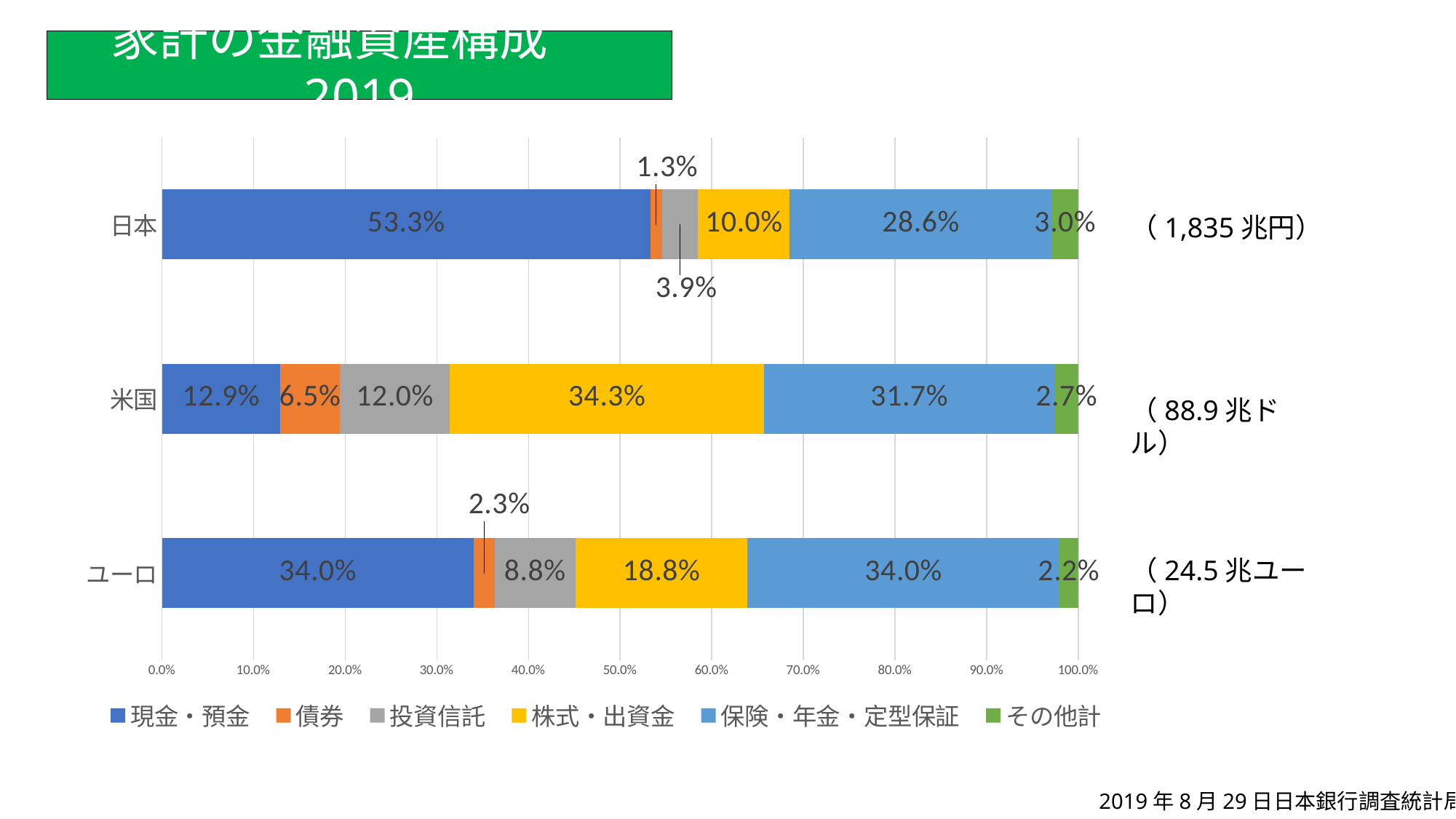
What is the value of 現金・預金 for 日本? 53.3% Which region has the highest value for 現金・預金? 日本 Which region has the lowest value for 株式・出資金? 日本 What is the value of 投資信託 for 日本? 3.9% Which is larger: 投資信託 for 米国 or 投資信託 for ユーロ? 米国 What is the value of 債券 for ユーロ? 2.3% What is the total amount shown next to the 日本 bar? 1,835 兆円 What is the value of 株式・出資金 for 米国? 34.3% What is the difference between the 保険・年金・定型保証 values for 米国 and 日本? 3.1% How many categories (regions) are plotted on the chart? 3 What type of chart is shown on the slide? Stacked bar chart How many series does the legend list? 6